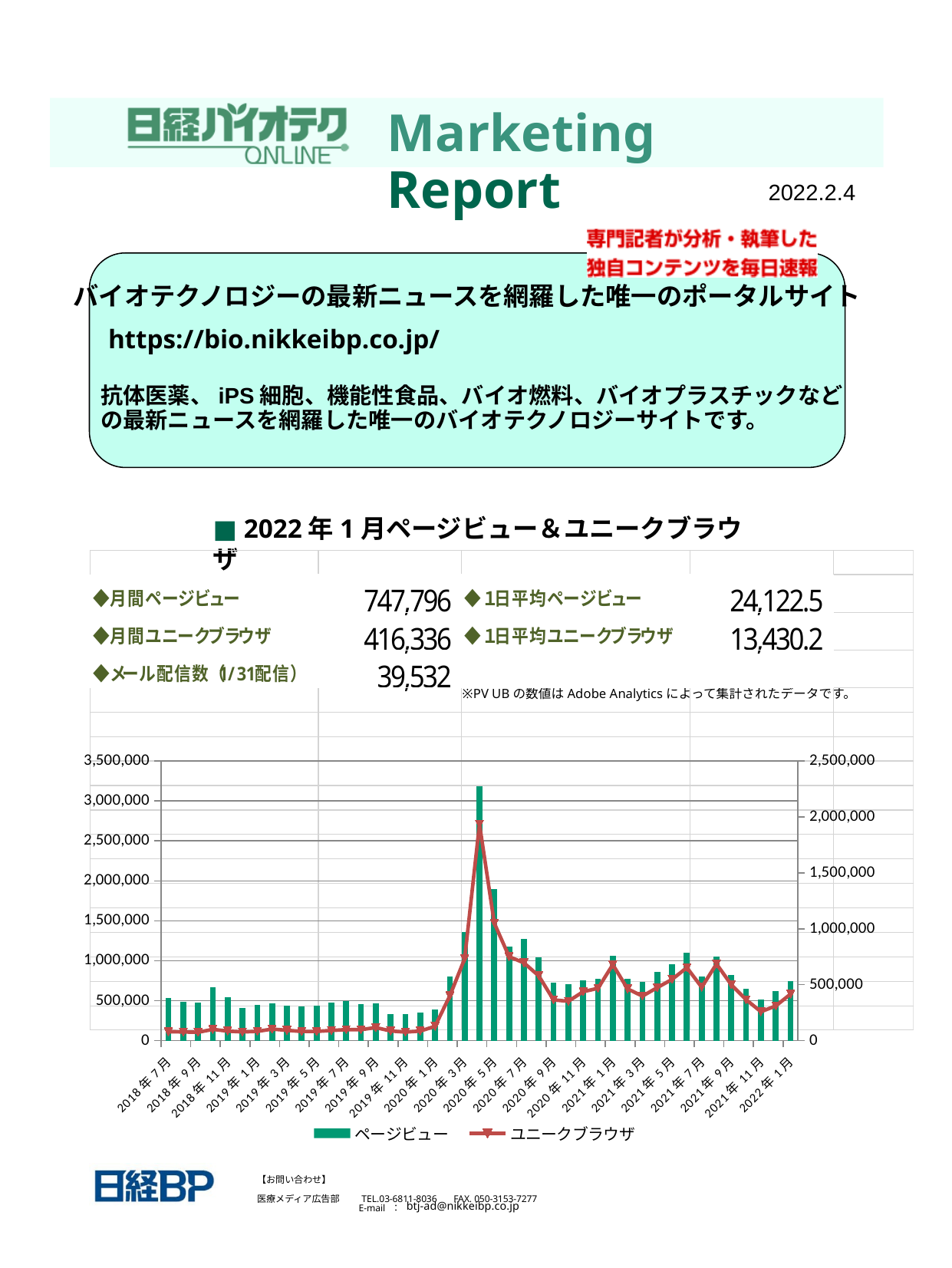
How many series does the chart legend list? 2 In which month do unique browsers (ユニークブラウザ) reach their highest value? 2020年4月 Is the page view value for 2020年4月 greater or less than 3,000,000? greater Which series is drawn as bars in the chart? ページビュー What is the maximum value shown on the left vertical axis? 3,500,000 Is the unique browser value for 2020年4月 greater or less than 1,500,000 on the right axis? greater Which series is drawn as a line in the chart? ユニークブラウザ In which month do page views (ページビュー) reach their highest value? 2020年4月 Do page views rise or fall from 2020年4月 to 2020年9月? fall Is the page view value for 2018年7月 greater or less than 1,000,000? less Which month has more page views, 2020年4月 or 2020年5月? 2020年4月 What kind of chart is shown on the slide? A combination bar and line chart